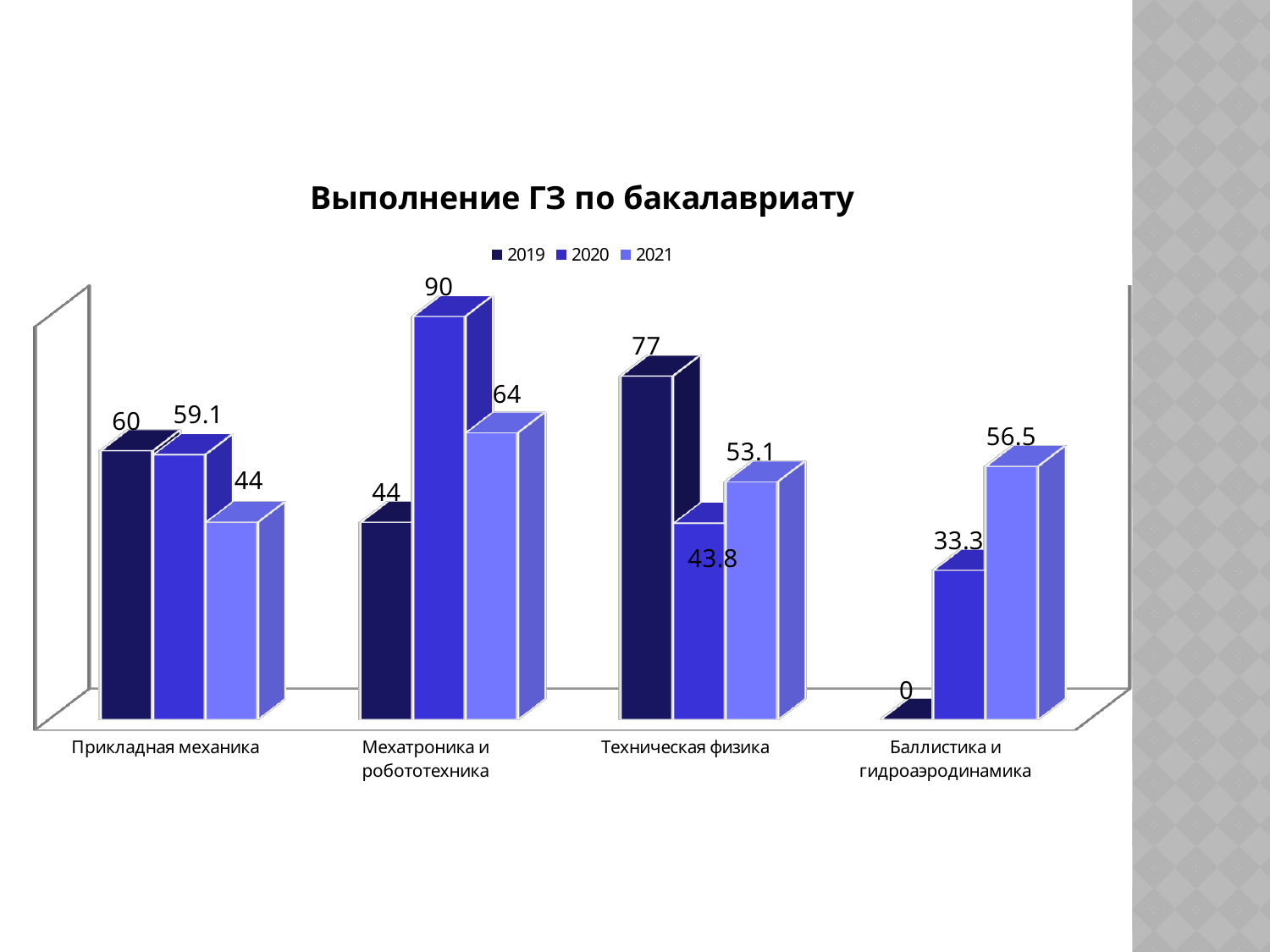
What kind of chart is shown on the slide? Bar chart What is the value for 2020 for Мехатроника и робототехника? 90 What is the value for 2020 for Прикладная механика? 59.1 How many categories are shown on the x axis? 4 What is the value for 2021 for Баллистика и гидроаэродинамика? 56.5 What is the difference between the 2020 and 2021 values for Мехатроника и робототехника? 26 Which category has the lowest value for 2020? Баллистика и гидроаэродинамика Which is larger for Техническая физика: the 2020 value or the 2021 value? 2021 Which category has the highest value for 2019? Техническая физика How many series does the legend list? 3 What is the title of the chart? Выполнение ГЗ по бакалавриату What is the value for 2019 for Техническая физика? 77